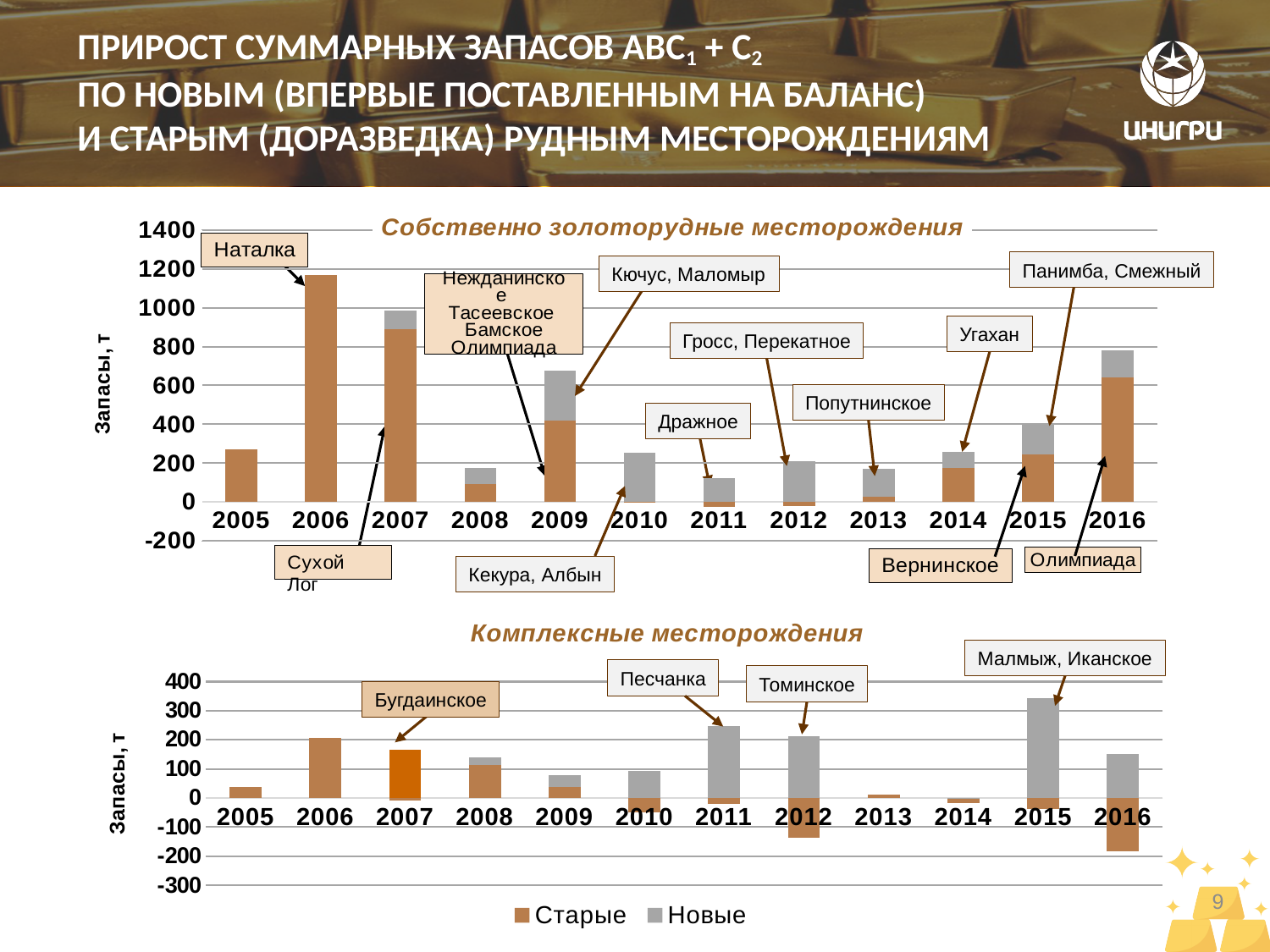
In the top chart 'Собственно золоторудные месторождения', how many years are shown on the x axis? 12 In the bottom chart 'Комплексные месторождения', is the 'Старые' value for 2016 greater or less than -100? less In the bottom chart 'Комплексные месторождения', which year has the tallest bar above zero? 2015 In the top chart 'Собственно золоторудные месторождения', is the value for 2006 greater or less than 1000? greater In the bottom chart 'Комплексные месторождения', is the value for 2015 greater or less than 300? greater How many series does the legend at the bottom of the slide list? 2 In the bottom chart 'Комплексные месторождения', which bar is taller, 2006 or 2009? 2006 What kind of chart is the top chart, 'Собственно золоторудные месторождения'? Bar chart In the top chart 'Собственно золоторудные месторождения', which year has the tallest bar? 2006 What are the two series names shown in the legend? Старые, Новые In the top chart 'Собственно золоторудные месторождения', which bar is taller, 2007 or 2009? 2007